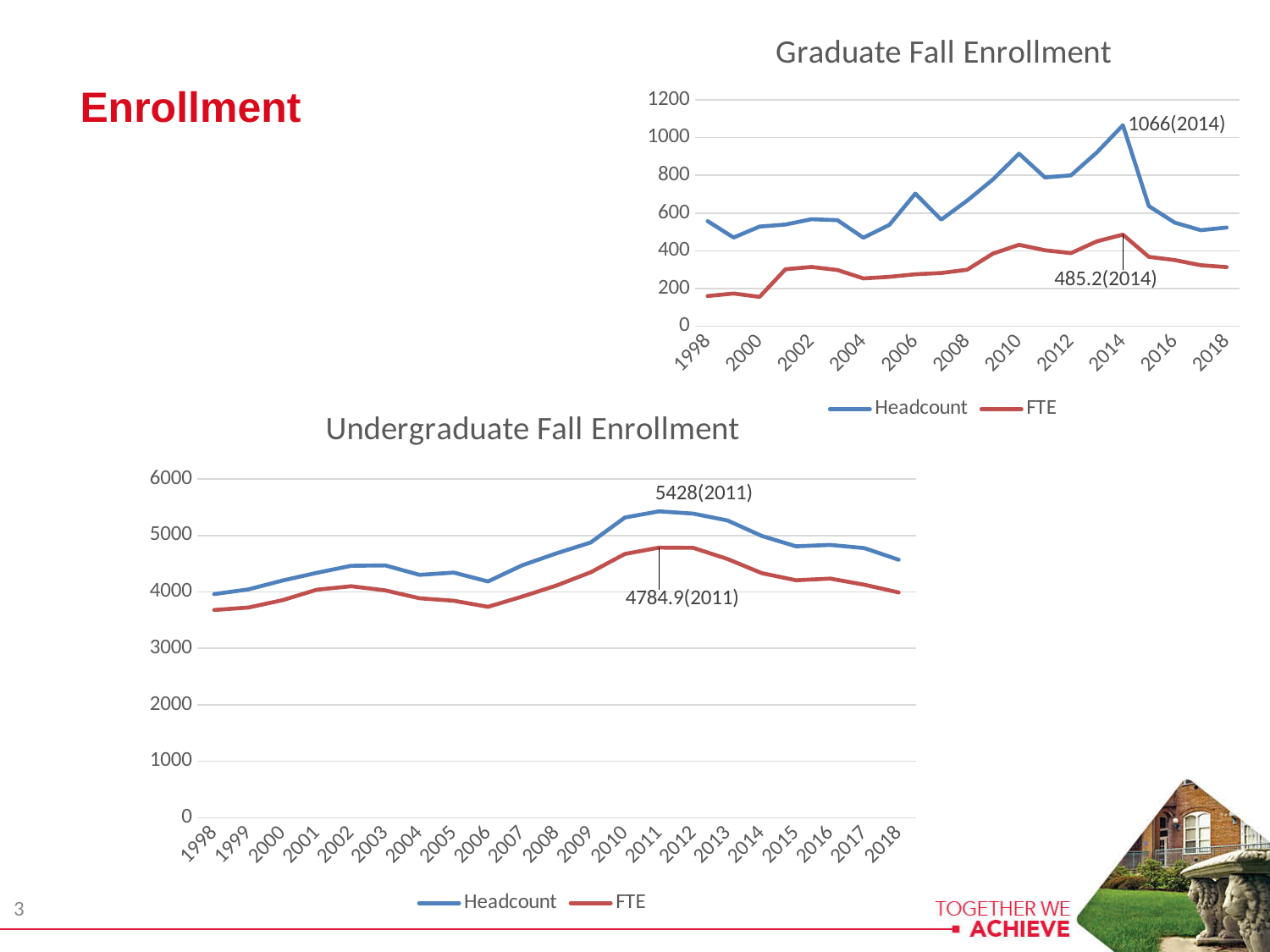
In the Undergraduate Fall Enrollment chart, is the FTE value for 2006 greater or less than 4000? less In the Graduate Fall Enrollment chart, what is the labelled peak Headcount value? 1066 How many series does the legend of the Undergraduate Fall Enrollment chart list? 2 What kind of chart is the Graduate Fall Enrollment chart? line chart In the Graduate Fall Enrollment chart, what is the difference between the labelled 2014 Headcount and the labelled 2014 FTE? 580.8 In the Undergraduate Fall Enrollment chart, what is the labelled peak Headcount value? 5428 In the Undergraduate Fall Enrollment chart, what is the difference between the labelled 2011 Headcount and the labelled 2011 FTE? 643.1 In the Graduate Fall Enrollment chart, does Headcount rise or fall from 2014 to 2018? fall In the Graduate Fall Enrollment chart, what is the labelled peak FTE value? 485.2 In the Graduate Fall Enrollment chart, in which year does Headcount reach its highest value? 2014 In the Graduate Fall Enrollment chart, is the Headcount value for 1998 greater or less than 400? greater In the Undergraduate Fall Enrollment chart, in which year does FTE reach its labelled peak? 2011